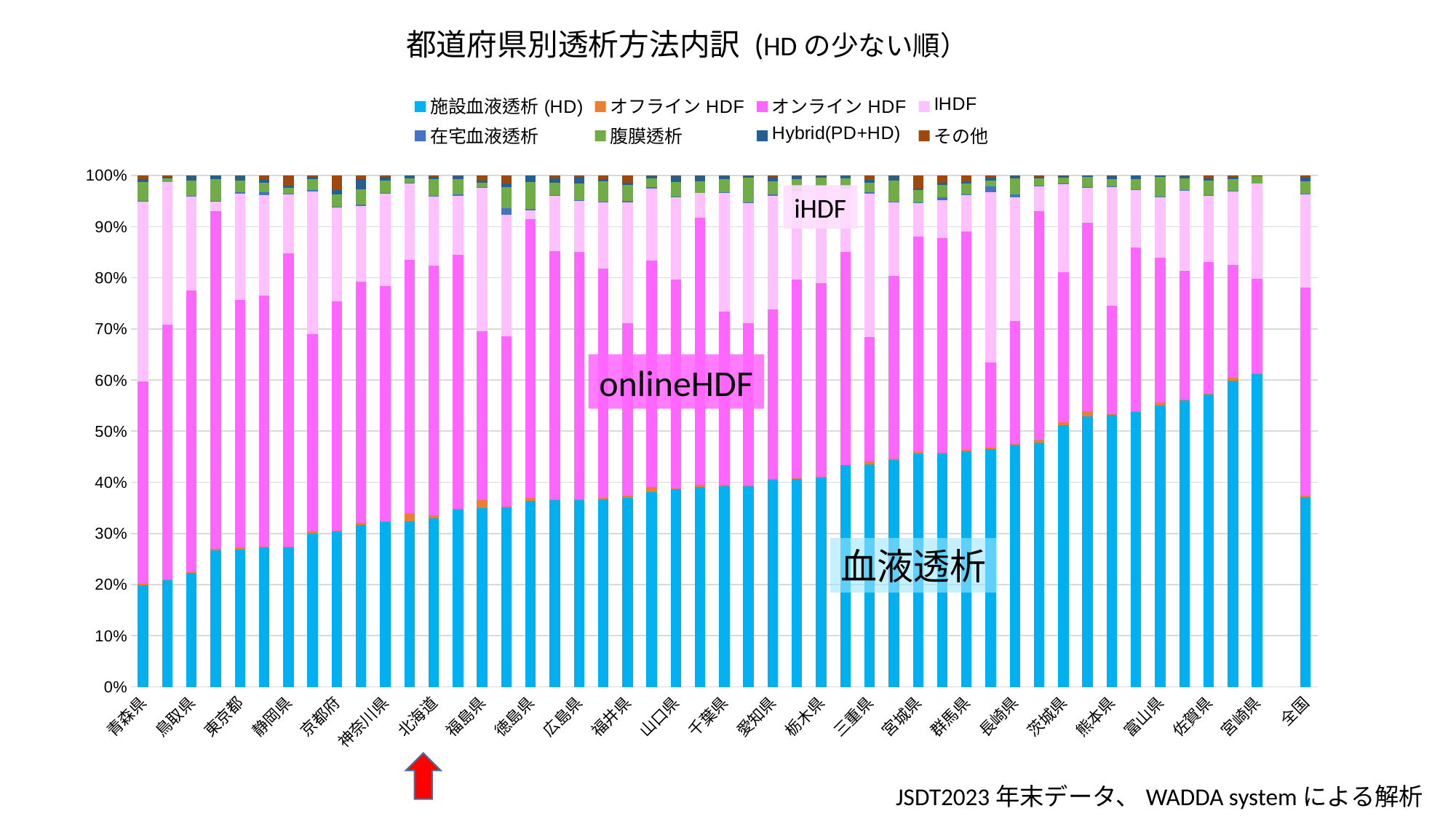
Is the 施設血液透析 (HD) share for 青森県 greater or less than 30%? less Is the 施設血液透析 (HD) share for 東京都 greater or less than 30%? less Does the 施設血液透析 (HD) share rise or fall moving left to right across the prefectures on the x axis? rise How many series does the legend list? 8 Which of the labeled prefectures has the highest 施設血液透析 (HD) share? 宮崎県 Is the 施設血液透析 (HD) share for 宮崎県 greater or less than 50%? greater Which has a larger 施設血液透析 (HD) share, 青森県 or 宮崎県? 宮崎県 What kind of chart is shown on the slide? Stacked bar chart Which series is listed first in the legend? 施設血液透析 (HD) What is the title of the chart? 都道府県別透析方法内訳（HD の少ない順） Which of the labeled prefectures has the lowest 施設血液透析 (HD) share? 青森県